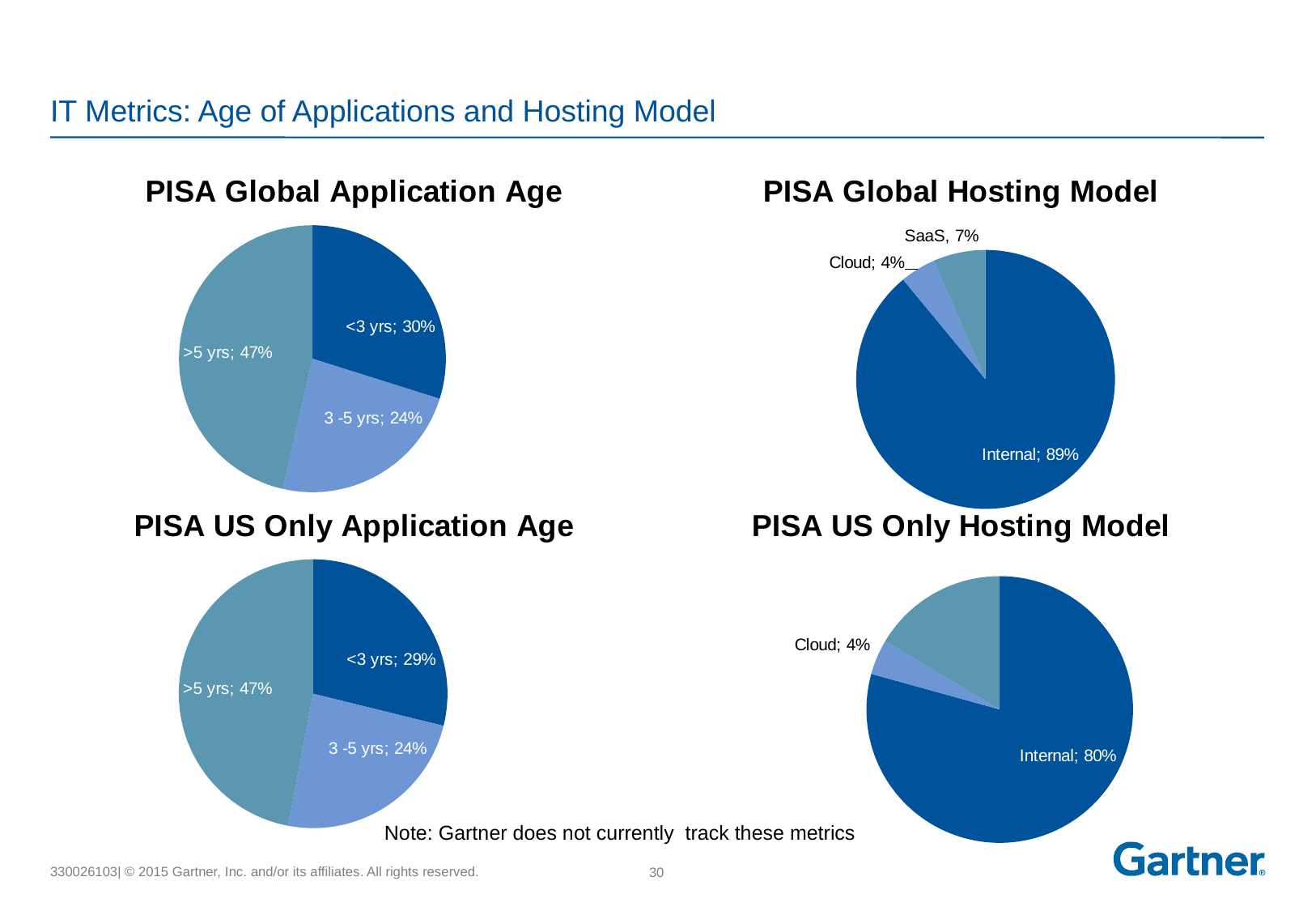
In the PISA Global Application Age chart, which age category has the largest share? >5 yrs What type of chart is the PISA Global Application Age chart? Pie chart In the PISA Global Application Age chart, what share of applications are <3 yrs old? 30% In the PISA Global Hosting Model chart, which hosting model has the smallest share? Cloud In the PISA Global Hosting Model chart, how many slices does the pie have? 3 In the PISA US Only Hosting Model chart, what is the share for Cloud? 4% In the PISA Global Hosting Model chart, what is the share for SaaS? 7% In the PISA US Only Application Age chart, what is the difference between the >5 yrs share and the 3 -5 yrs share? 23% In the PISA Global Hosting Model chart, what is the share for Internal? 89% In the PISA US Only Application Age chart, what share of applications are <3 yrs old? 29% In the PISA US Only Hosting Model chart, what is the share for Internal? 80% In the PISA Global Application Age chart, what share of applications are 3 -5 yrs old? 24%